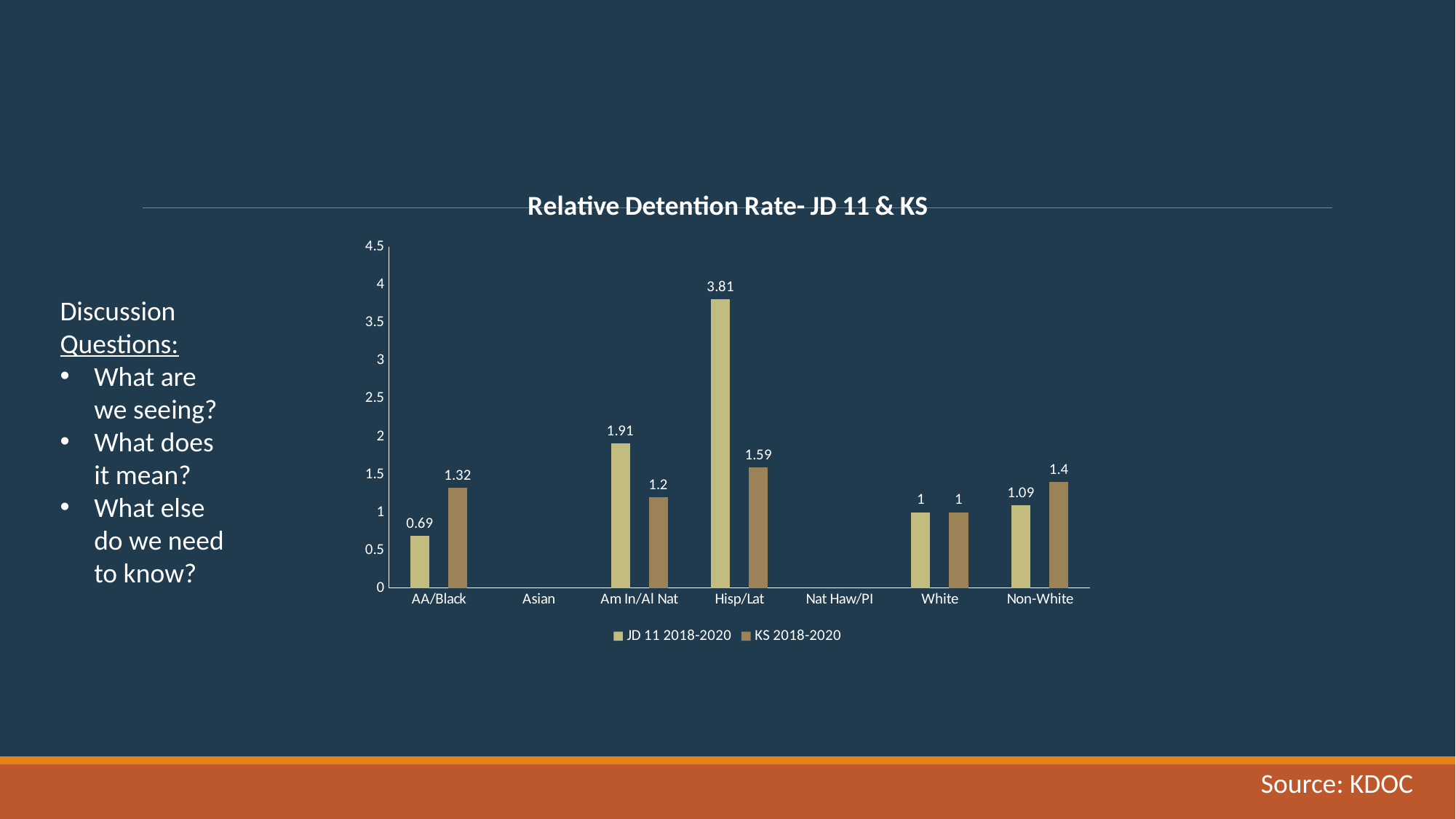
How many series does the legend list? 2 What is the JD 11 2018-2020 value for Hisp/Lat? 3.81 Which category has the highest KS 2018-2020 value? Hisp/Lat How many categories are shown on the x axis? 7 What is the KS 2018-2020 value for Non-White? 1.4 Is the JD 11 2018-2020 value for Hisp/Lat greater or less than 3.5? greater What is the KS 2018-2020 value for AA/Black? 1.32 What type of chart is shown on the slide? Bar chart What is the JD 11 2018-2020 value for Am In/Al Nat? 1.91 Which is larger for AA/Black: the JD 11 2018-2020 value or the KS 2018-2020 value? KS 2018-2020 What is the difference between the JD 11 2018-2020 and KS 2018-2020 values for Hisp/Lat? 2.22 Which category has the highest JD 11 2018-2020 value? Hisp/Lat